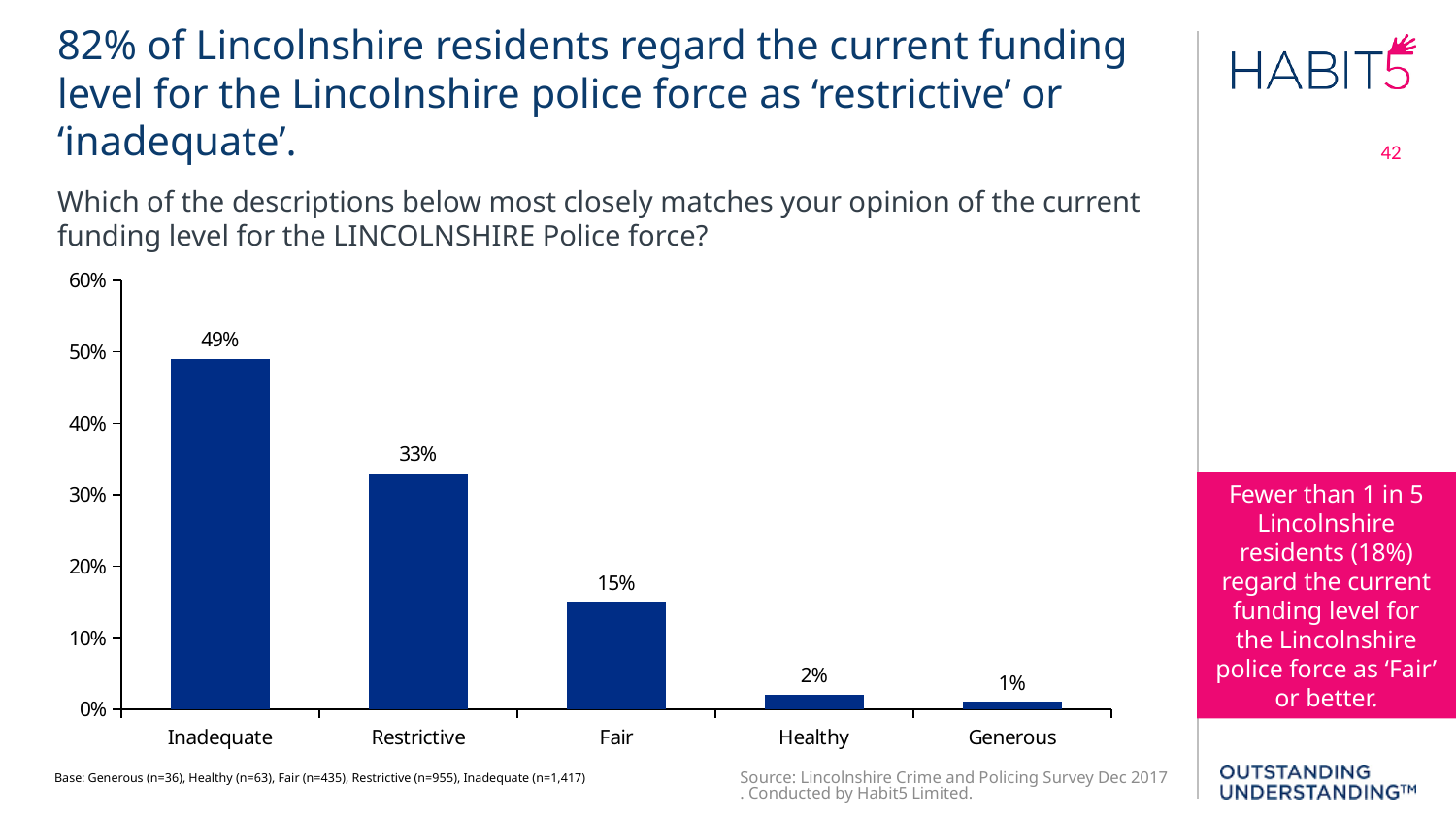
What kind of chart is shown on the slide? Bar chart What percentage of respondents chose 'Fair'? 15% Do the values rise or fall moving from left to right along the x axis? Fall Is the value for 'Restrictive' greater or less than 30%? greater Which category has the highest value? Inadequate What is the difference between the 'Inadequate' and 'Restrictive' values? 16% What is the value for 'Generous'? 1% What percentage of respondents described the funding level as 'Inadequate'? 49% How many categories are shown on the x axis? 5 What is the value shown for the 'Restrictive' category? 33% Which category has the lowest value? Generous Which is larger, the value for 'Fair' or the value for 'Healthy'? Fair